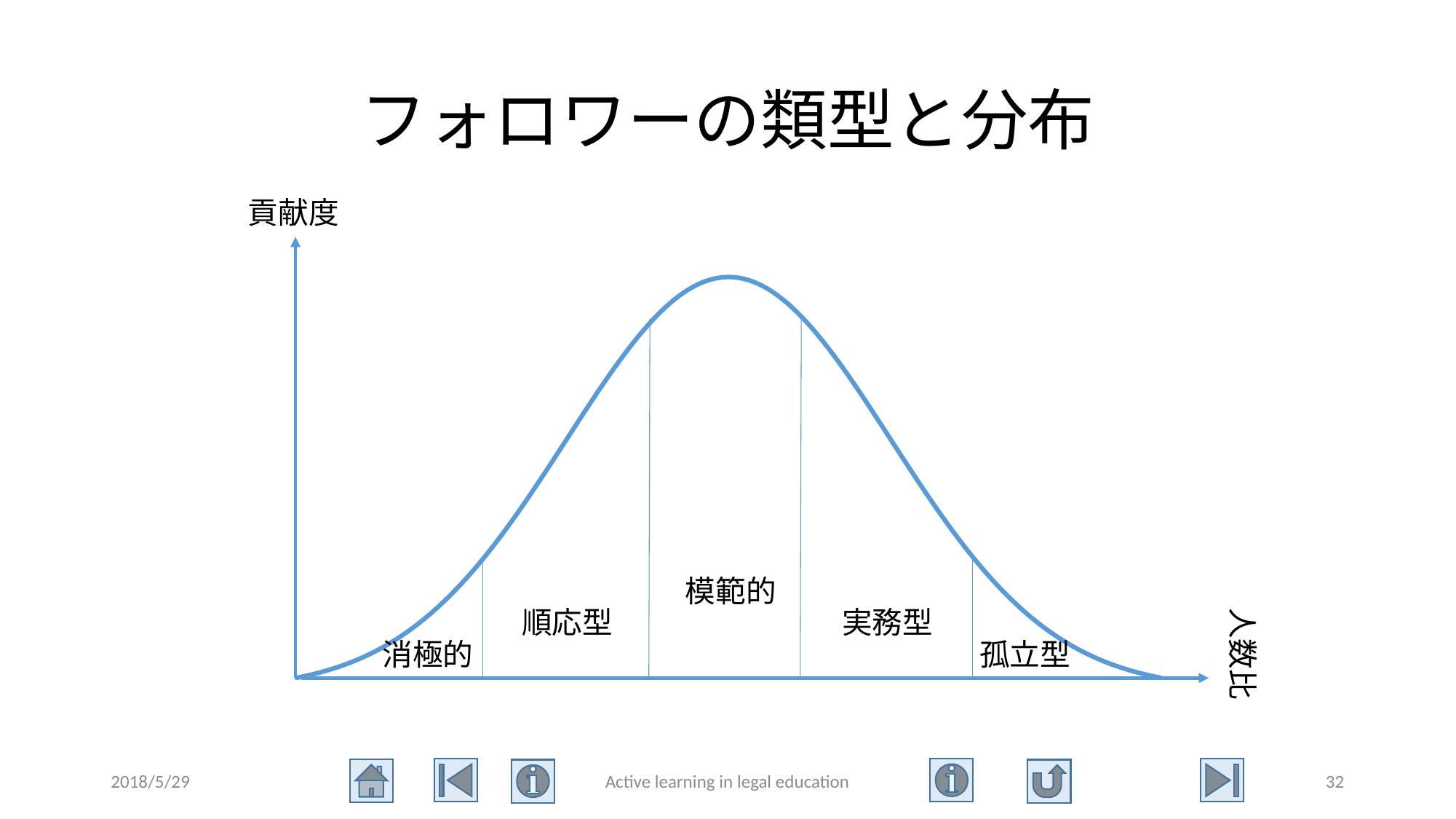
Which region has the higher curve, 順応型 or 消極的? 順応型 What is the label of the vertical axis? 貢献度 Which region has the higher curve, 実務型 or 孤立型? 実務型 How many follower types are labelled along the x axis of the chart? 5 Does the curve rise or fall from the 模範的 region toward the right edge? fall Which follower type is located at the peak of the curve? 模範的 What is the title of the chart on the slide? フォロワーの類型と分布 Which follower type is labelled furthest to the left on the x axis? 消極的 What kind of chart is shown on the slide? line chart (bell curve) Does the curve rise or fall from the left edge toward the 模範的 region? rise Which follower type is labelled furthest to the right on the x axis? 孤立型